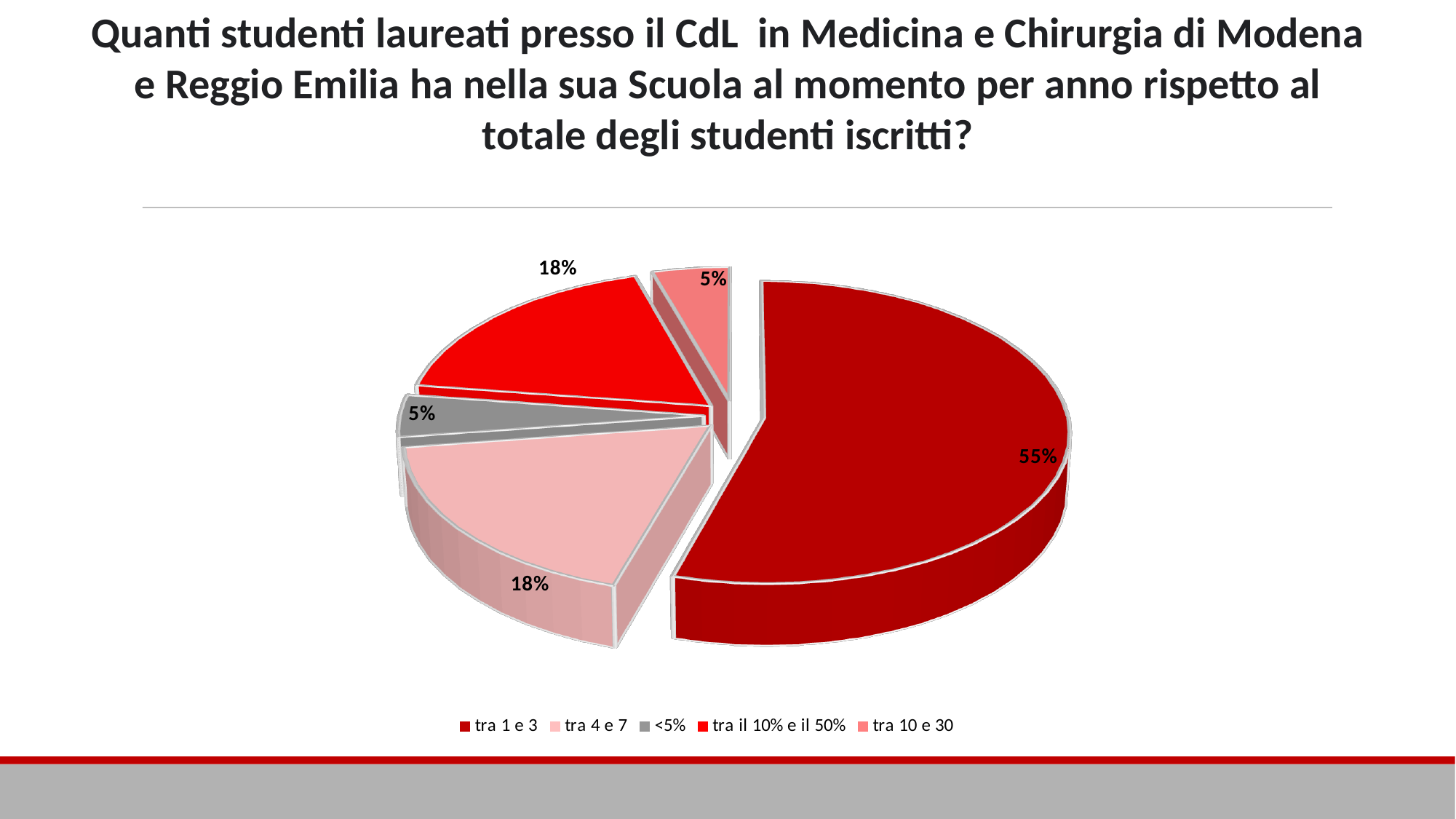
Which category has the largest slice of the pie? tra 1 e 3 How many entries does the legend list? 5 How many slices does the pie chart have? 5 Which is larger, the slice for 'tra 1 e 3' or the slice for 'tra 4 e 7'? tra 1 e 3 What is the value shown for '<5%'? 5% What is the difference in percentage points between the 'tra 1 e 3' slice and the 'tra 4 e 7' slice? 37 What is the value shown for 'tra 10 e 30'? 5% What is the value shown for 'tra 4 e 7'? 18% Which legend entry is shown in gray? <5% What kind of chart is shown on the slide? pie chart What share of the pie does the 'tra 1 e 3' slice represent? 55% What is the value shown for 'tra il 10% e il 50%'? 18%